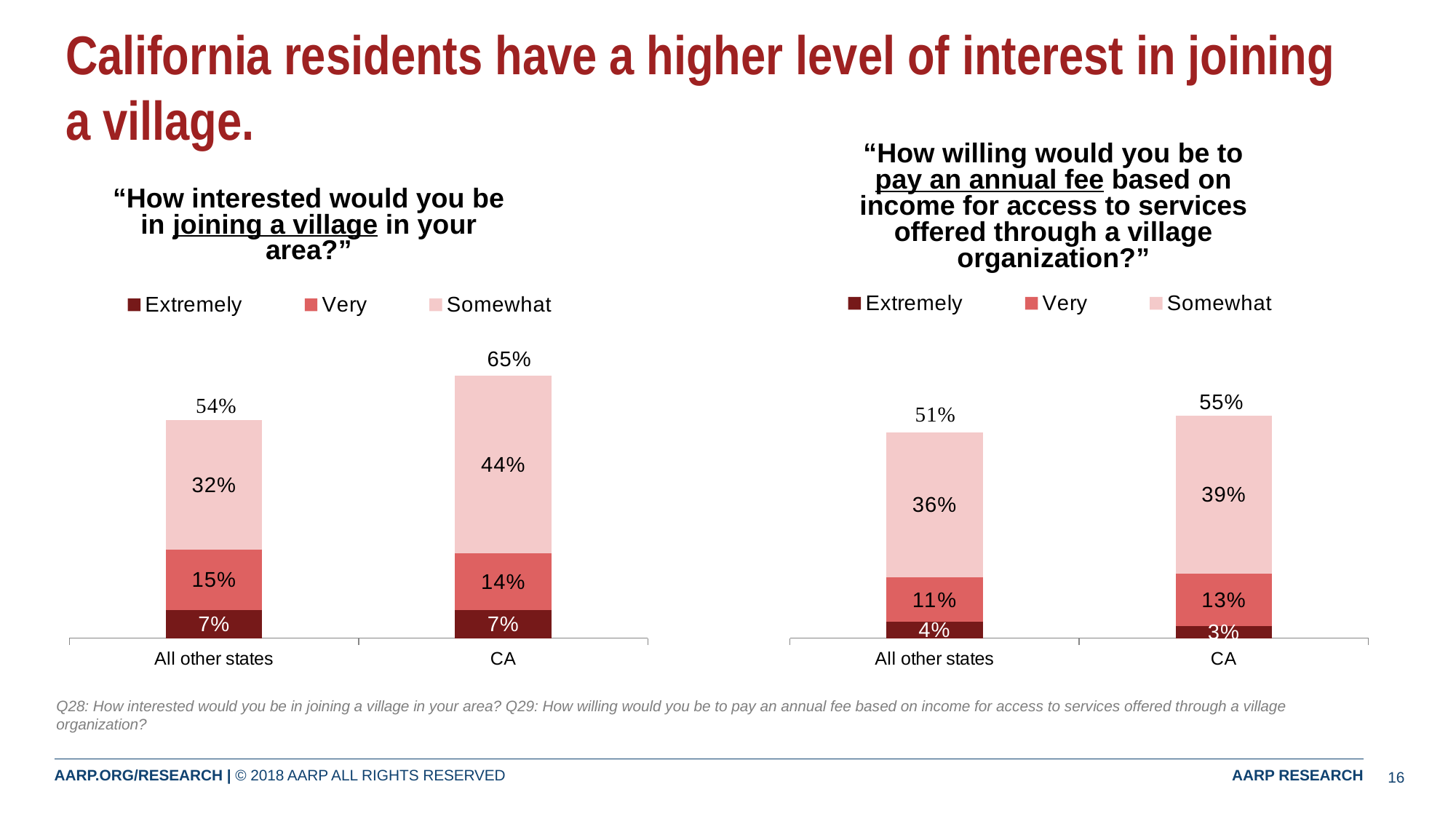
In the left chart (joining a village), what is the difference between the 'Somewhat' values for CA and All other states? 12% In the right chart (pay an annual fee), what is the 'Very' value for CA? 13% How many categories are shown on the x axis of the right chart? 2 In the left chart (joining a village), what is the 'Somewhat' value for CA? 44% In the right chart (pay an annual fee), which category has the larger 'Somewhat' value, CA or All other states? CA In the right chart (pay an annual fee), what is the total of the stacked bar for All other states? 51% In the right chart (pay an annual fee), what is the 'Extremely' value for All other states? 4% In the left chart (joining a village), what is the total of the stacked bar for CA? 65% How many series does the legend of the left chart list? 3 What kind of chart is the left chart (joining a village)? Stacked bar chart In the right chart (pay an annual fee), which category has the lowest 'Extremely' value? CA In the left chart (joining a village), what is the 'Very' value for All other states? 15%